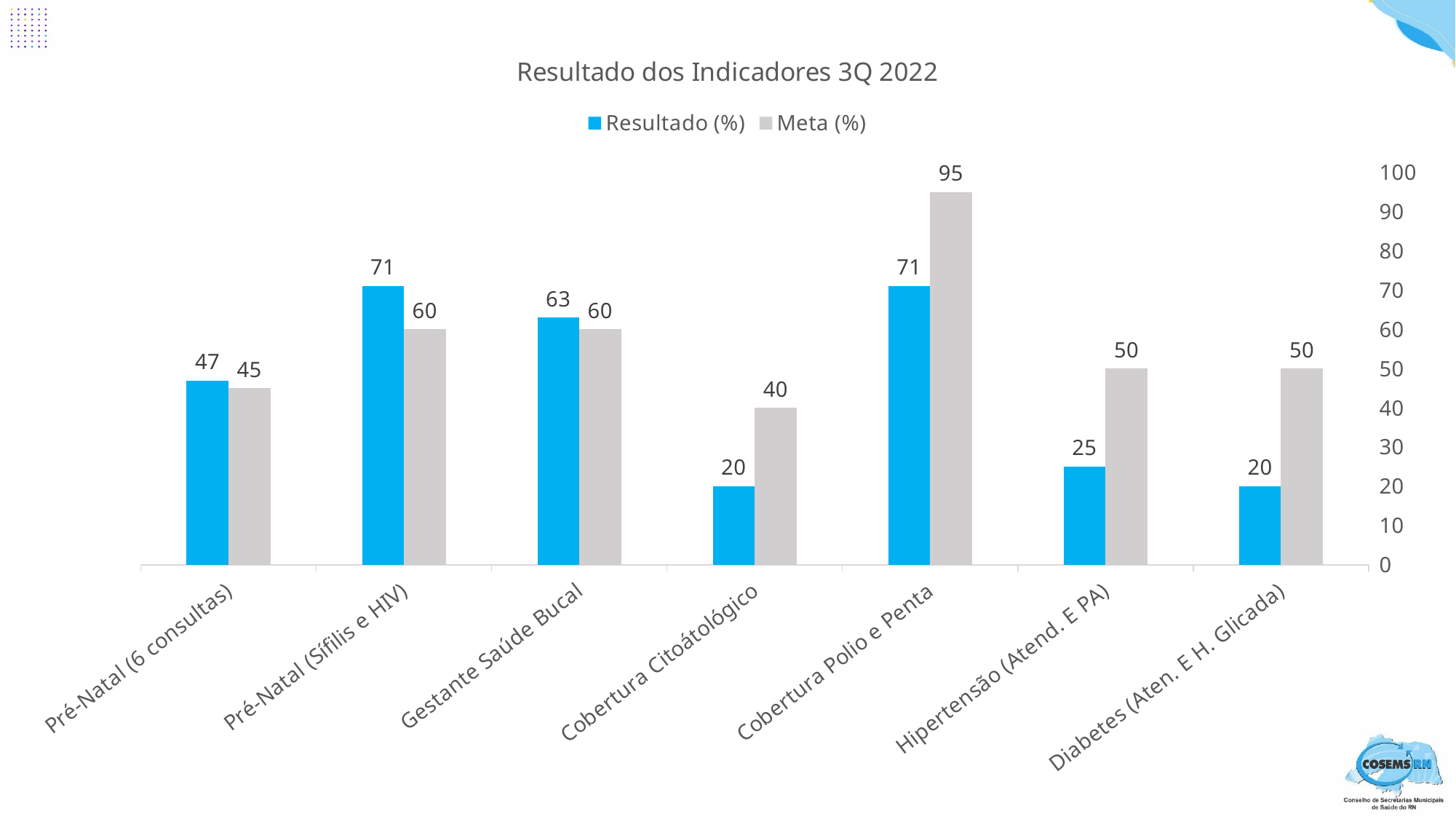
Which is larger for Pré-Natal (6 consultas): the Resultado (%) or the Meta (%)? Resultado (%) Which category has the lowest Meta (%) value? Cobertura Citoátológico Is the Resultado (%) value for Diabetes (Aten. E H. Glicada) greater or less than 30? less How many series does the legend list? 2 What is the title of the chart? Resultado dos Indicadores 3Q 2022 What is the Resultado (%) value for Hipertensão (Atend. E PA)? 25 What is the Meta (%) value for Cobertura Polio e Penta? 95 Which category has the highest Meta (%) value? Cobertura Polio e Penta What kind of chart is shown on the slide? Bar chart What is the Resultado (%) value for Gestante Saúde Bucal? 63 What is the difference between the Meta (%) and Resultado (%) values for Cobertura Polio e Penta? 24 How many categories are shown on the x axis? 7